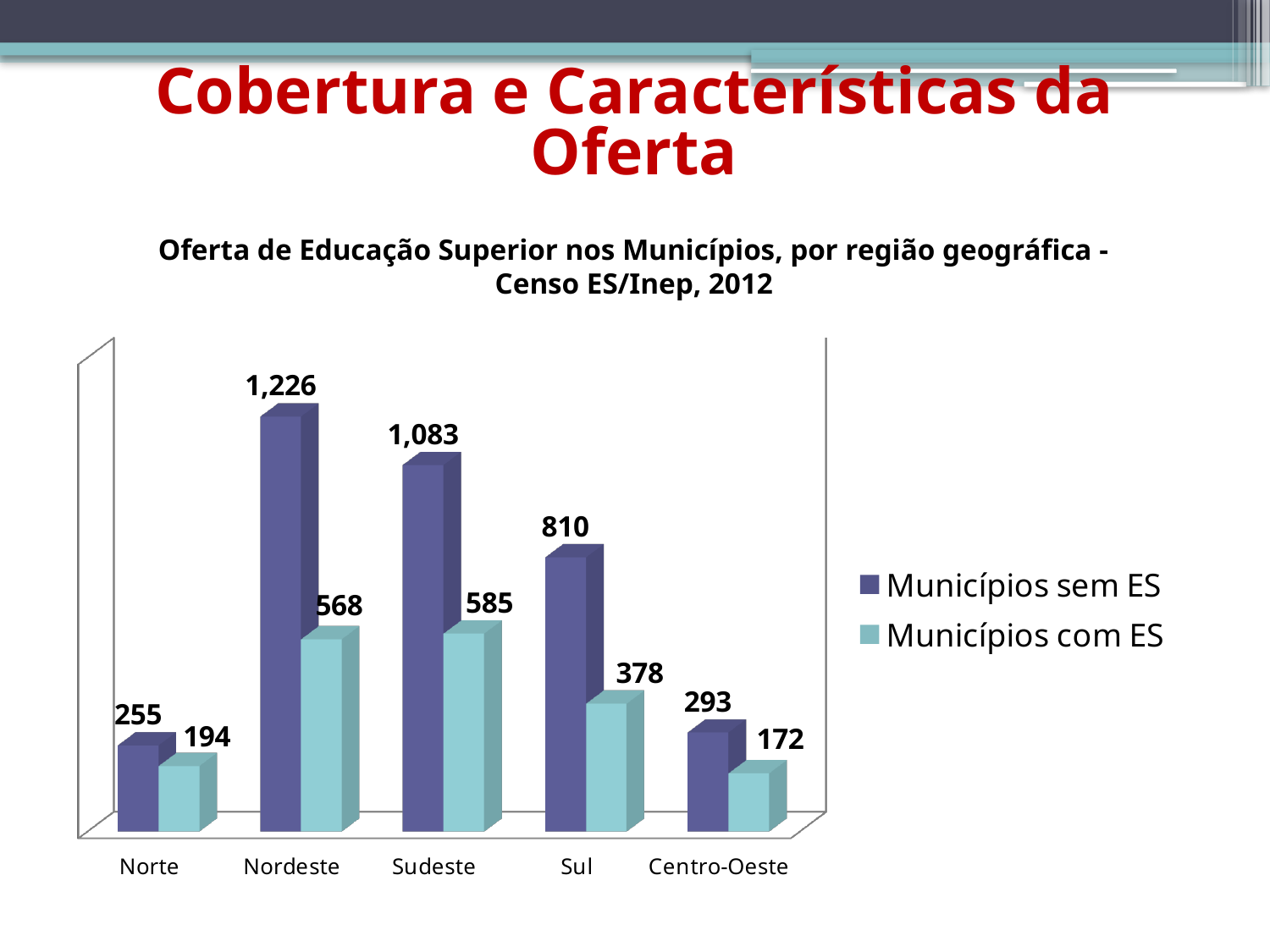
How many regions are shown on the x axis? 5 What is the value for Municípios com ES in Sul? 378 What is the value for Municípios sem ES in Nordeste? 1,226 What kind of chart is shown on the slide? Bar chart What is the difference between Municípios sem ES and Municípios com ES in Sudeste? 498 Which region has the highest value for Municípios sem ES? Nordeste Which is larger: Municípios com ES in Nordeste or Municípios com ES in Sudeste? Sudeste How many series does the legend list? 2 What is the value for Municípios com ES in Centro-Oeste? 172 Which series is shown in light blue in the legend? Municípios com ES What is the difference between Municípios sem ES in Nordeste and Municípios sem ES in Sul? 416 Which region has the lowest value for Municípios com ES? Centro-Oeste